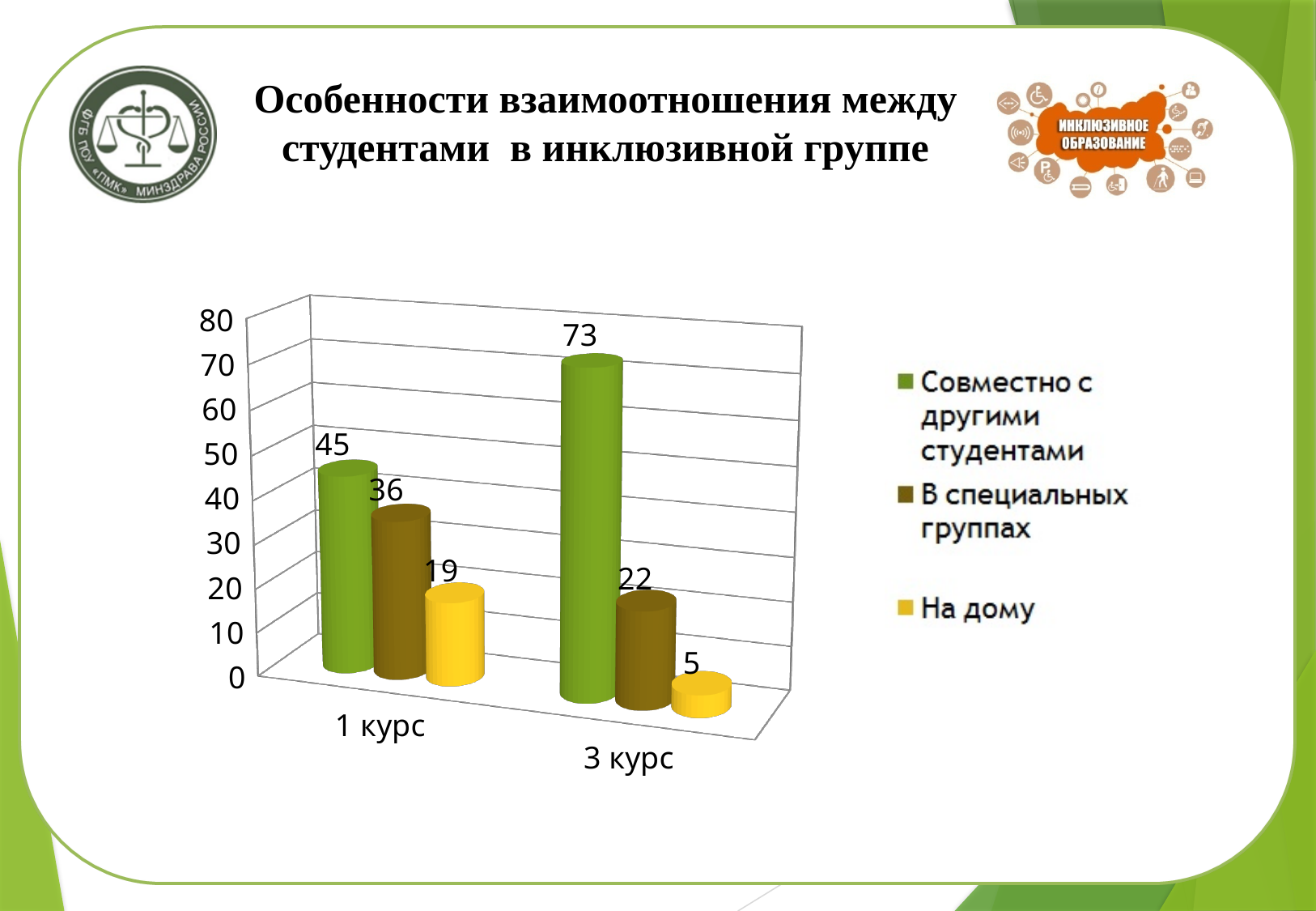
What kind of chart is shown on the slide? bar chart What is the difference between the "Совместно с другими студентами" values for 3 курс and 1 курс? 28 Which series has the lowest value for 3 курс? На дому What colour are the bars for the "На дому" series? yellow What is the value for "На дому" for 1 курс? 19 How many series does the legend list? 3 Is the value for "На дому" for 3 курс greater or less than 10? less What is the value for "В специальных группах" for 3 курс? 22 How many categories are shown on the x axis? 2 Which is larger: "В специальных группах" for 1 курс or for 3 курс? 1 курс Which category has the highest value for "Совместно с другими студентами"? 3 курс What is the value for "Совместно с другими студентами" for 1 курс? 45